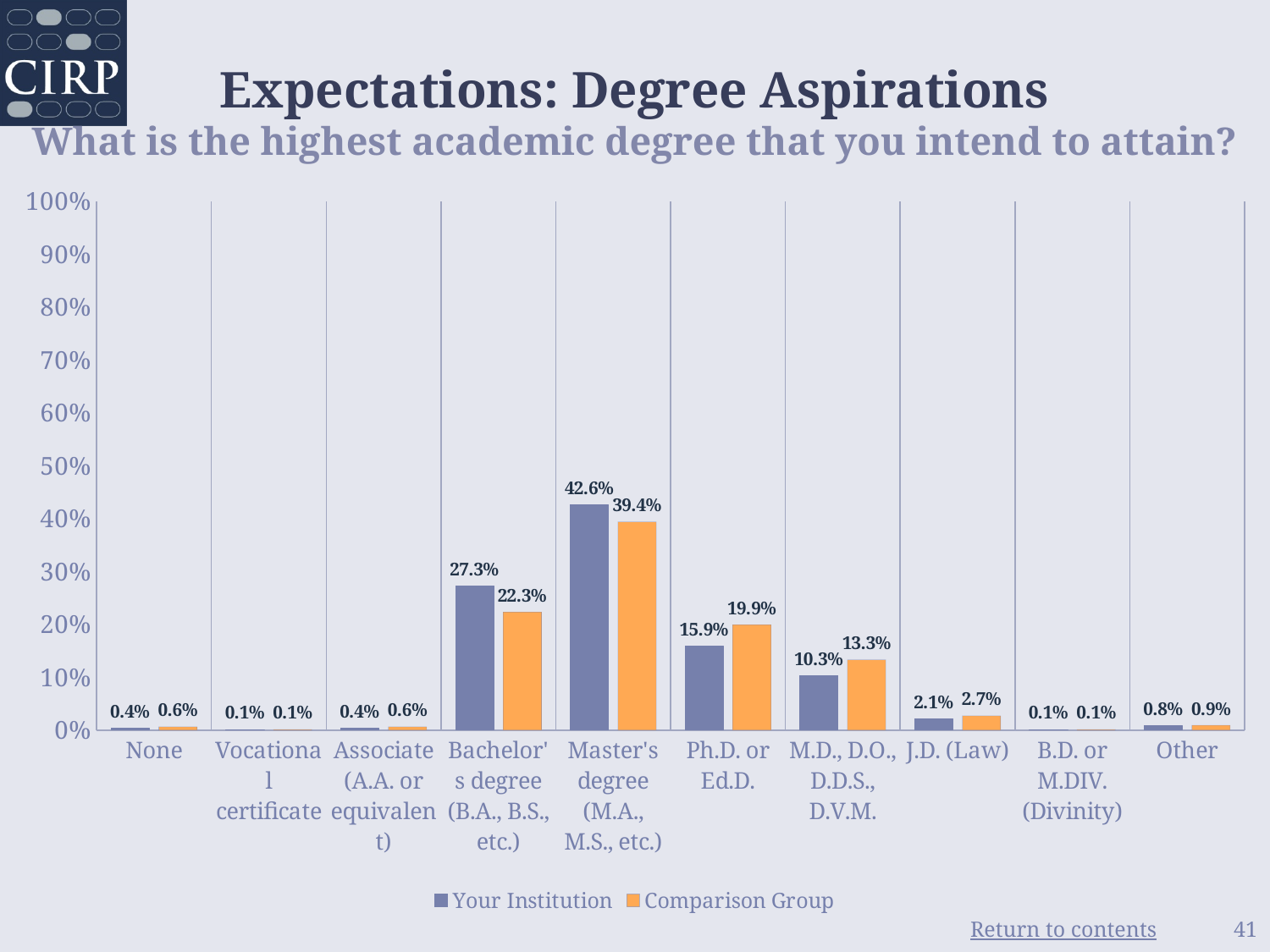
Which category has the highest value for Your Institution? Master's degree (M.A., M.S., etc.) What kind of chart is shown on the slide? bar chart Which is larger for Bachelor's degree (B.A., B.S., etc.), Your Institution or Comparison Group? Your Institution What is the value for Your Institution for Master's degree (M.A., M.S., etc.)? 42.6% Is the value for Your Institution for Master's degree (M.A., M.S., etc.) greater or less than 40%? greater What is the difference between Your Institution and Comparison Group for M.D., D.O., D.D.S., D.V.M.? 3.0% What is the value for Comparison Group for Bachelor's degree (B.A., B.S., etc.)? 22.3% What is the difference between Your Institution and Comparison Group for Master's degree (M.A., M.S., etc.)? 3.2% What is the value for Comparison Group for Ph.D. or Ed.D.? 19.9% Which is larger for Ph.D. or Ed.D., Your Institution or Comparison Group? Comparison Group How many categories are shown on the x axis? 10 How many series does the legend list? 2